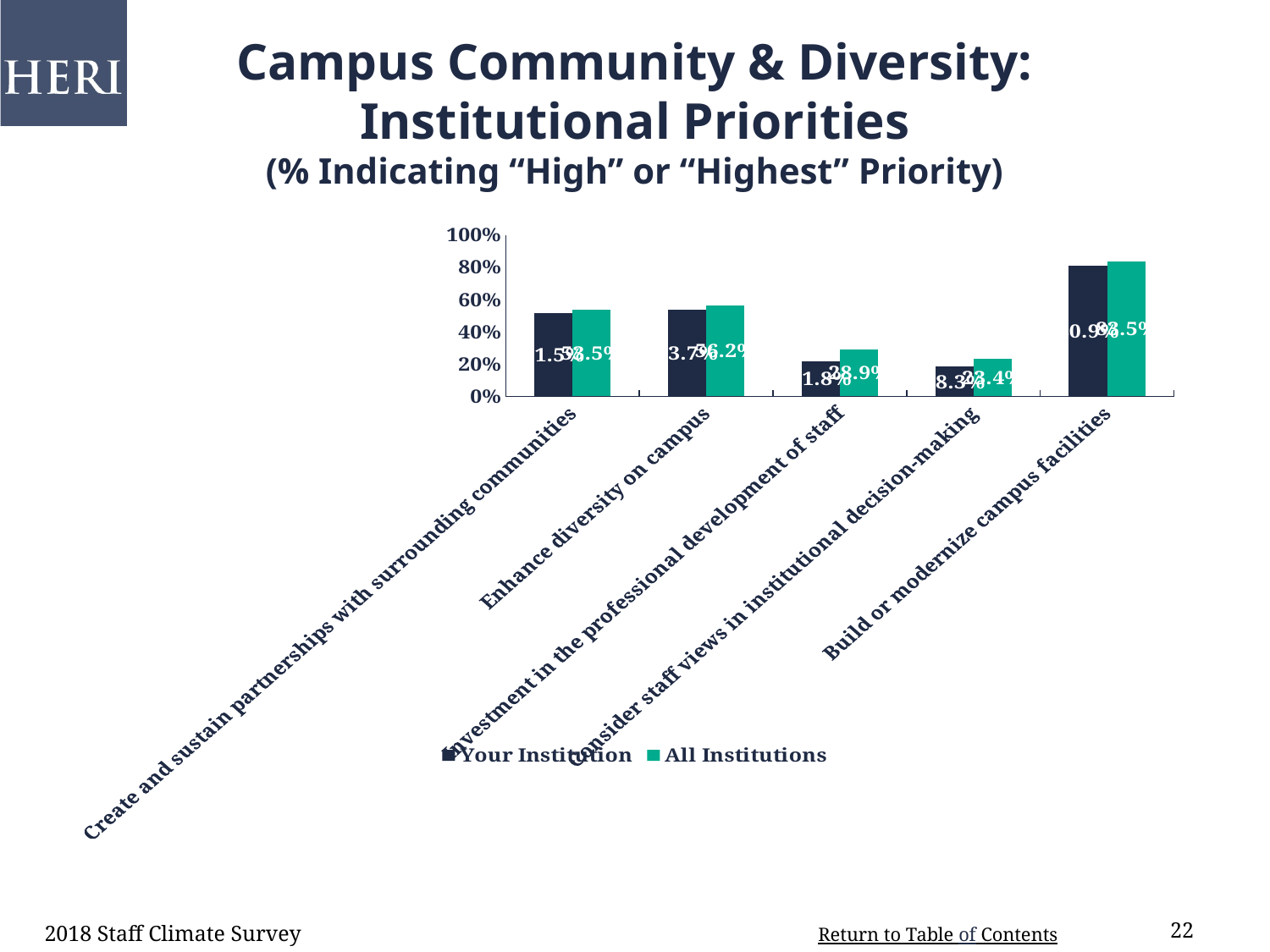
Is the Your Institution value for Build or modernize campus facilities greater or less than 60%? greater Which category has the lowest value for Your Institution? Consider staff views in institutional decision-making Is the Your Institution value for Consider staff views in institutional decision-making greater or less than 40%? less Is the All Institutions value for Enhance diversity on campus greater or less than 40%? greater How many categories are shown on the x axis? 5 For Investment in the professional development of staff, which series has the larger value, Your Institution or All Institutions? All Institutions Which category has the highest values for both series? Build or modernize campus facilities What colour are the bars for the All Institutions series? green Which category has the lowest value for All Institutions? Consider staff views in institutional decision-making What are the two legend entries of the chart? Your Institution and All Institutions What kind of chart is shown on the slide? bar chart How many series does the legend list? 2